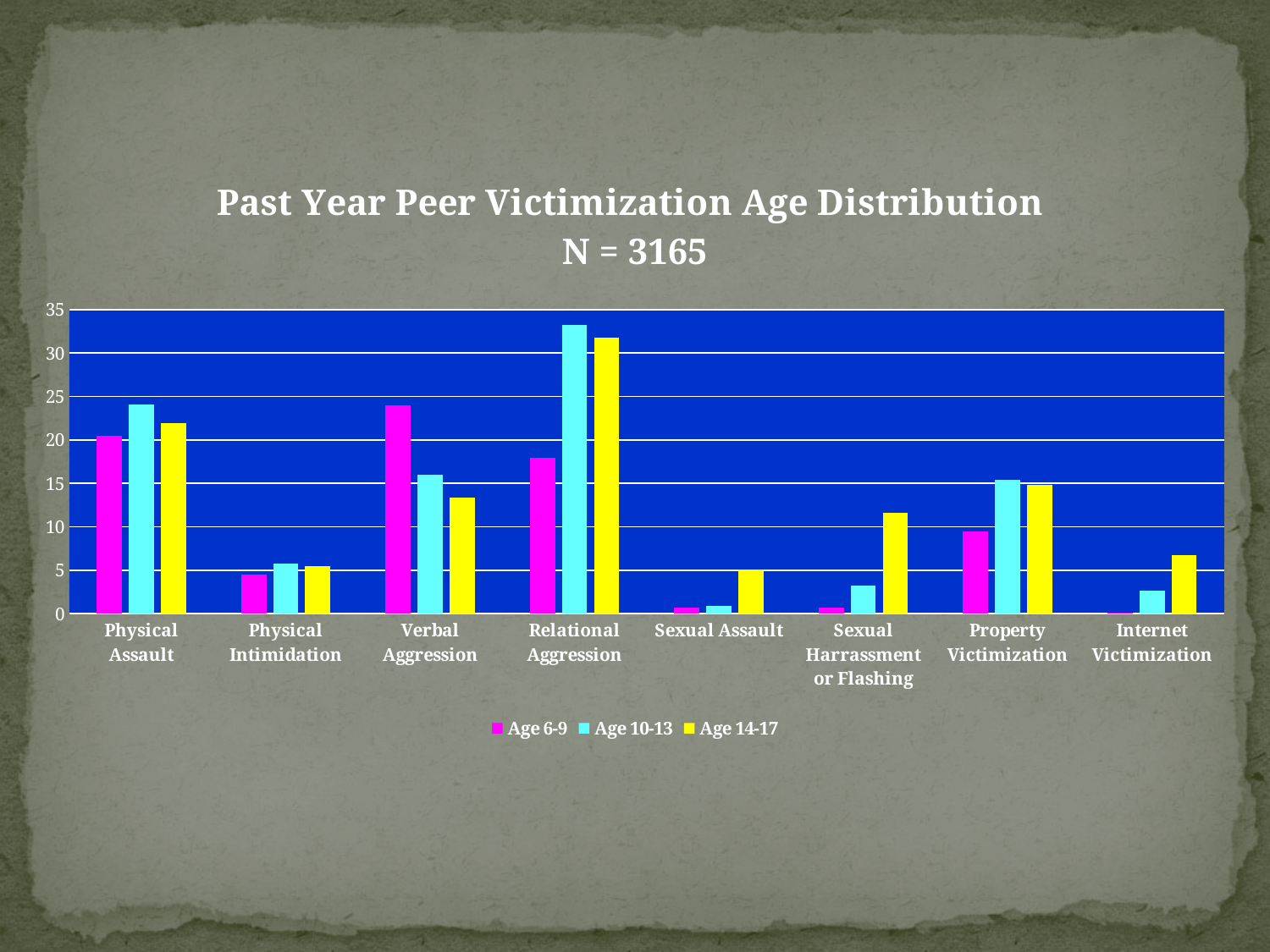
How many series does the legend list? 3 Is the Age 14-17 value for Verbal Aggression greater or less than 15? less Is the Age 14-17 value for Sexual Harrassment or Flashing greater or less than 10? greater Which category has the lowest value for Age 10-13? Sexual Assault Which category has the highest value for Age 6-9? Verbal Aggression For Verbal Aggression, which is larger: the Age 6-9 value or the Age 14-17 value? Age 6-9 For Physical Assault, which is larger: the Age 6-9 value or the Age 10-13 value? Age 10-13 What kind of chart is shown on the slide? Bar chart What is the sample size (N) stated in the chart title? 3165 Is the Age 10-13 value for Relational Aggression greater or less than 30? greater Which category has the highest value for Age 10-13? Relational Aggression How many victimization categories are shown along the x axis? 8